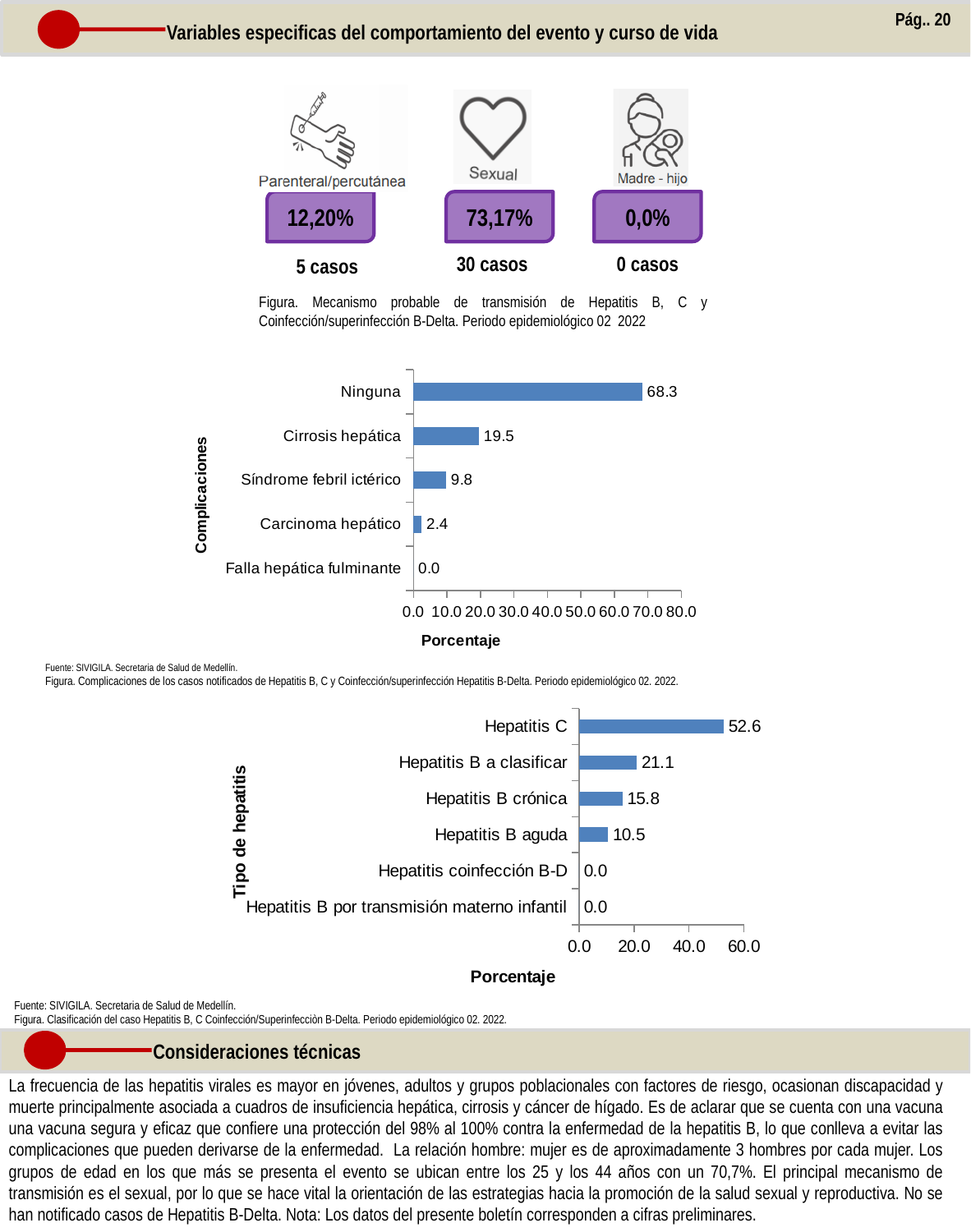
In the Complicaciones chart, which complication has the highest percentage? Ninguna In the Complicaciones chart, what is the difference between Ninguna and Cirrosis hepática? 48.8 In the Tipo de hepatitis chart, how many categories are listed on the y axis? 6 In the Complicaciones chart, how many categories are shown on the y axis? 5 In the Tipo de hepatitis chart, what is the value for Hepatitis B crónica? 15.8 In the Tipo de hepatitis chart, what is the difference between Hepatitis C and Hepatitis B a clasificar? 31.5 In the Complicaciones chart, what is the value for Falla hepática fulminante? 0.0 In the Tipo de hepatitis chart, which is larger, Hepatitis B a clasificar or Hepatitis B aguda? Hepatitis B a clasificar What is the x-axis title of the Complicaciones chart? Porcentaje In the Complicaciones chart, what is the value for Cirrosis hepática? 19.5 In the Tipo de hepatitis chart, which type has the highest percentage? Hepatitis C What kind of chart is the Tipo de hepatitis chart? Bar chart